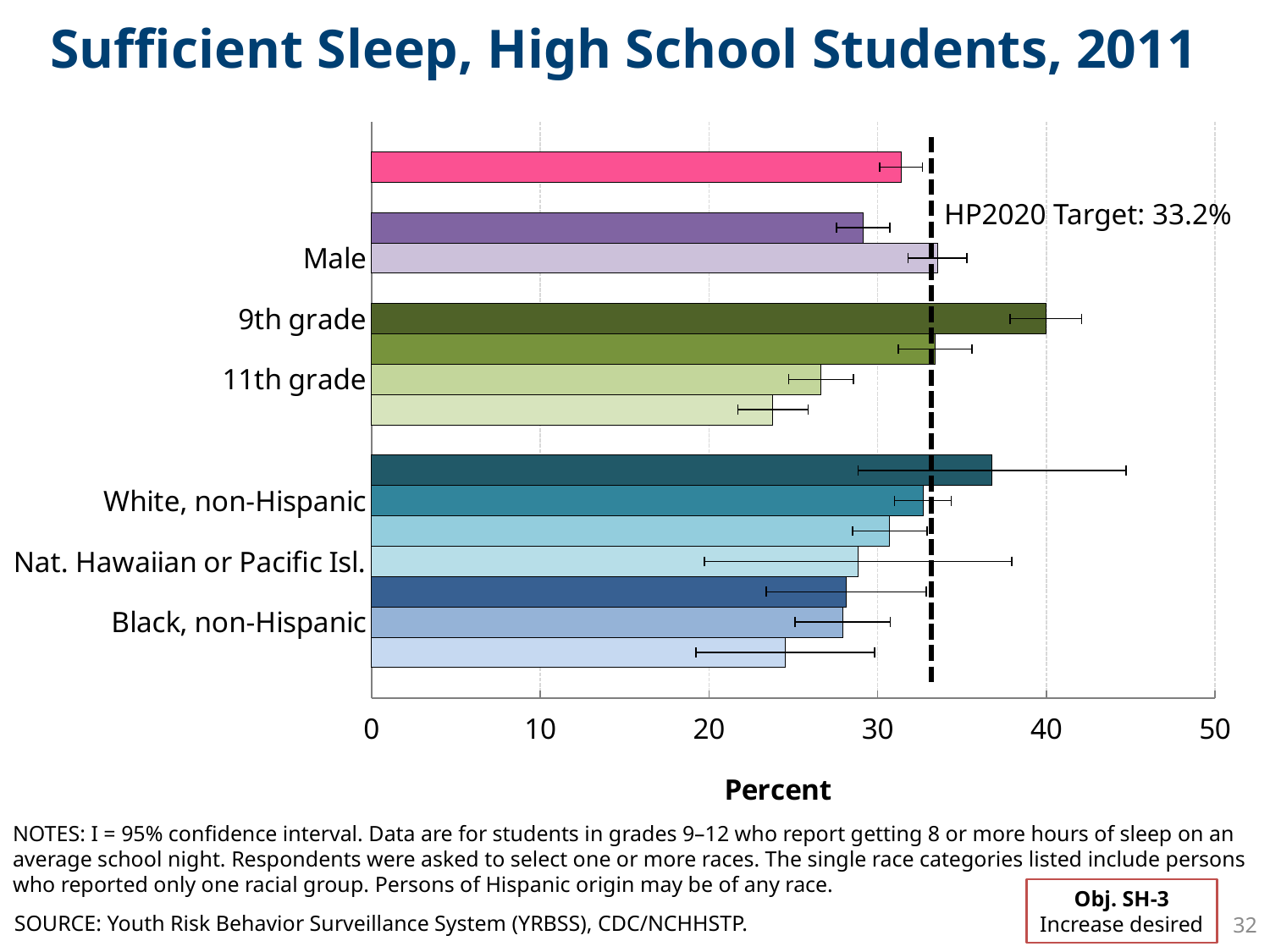
What is the title of the x axis? Percent Is the value for Nat. Hawaiian or Pacific Isl. greater or less than 30? less What is the HP2020 Target value shown on the chart? 33.2% What kind of chart is shown on the slide? bar chart Which has the larger value, 9th grade or 11th grade? 9th grade Is the value for 9th grade greater or less than 30? greater Is the value for 11th grade greater or less than 30? less Which has the larger value, Male or Black, non-Hispanic? Male Among the labeled categories, which has the highest value? 9th grade